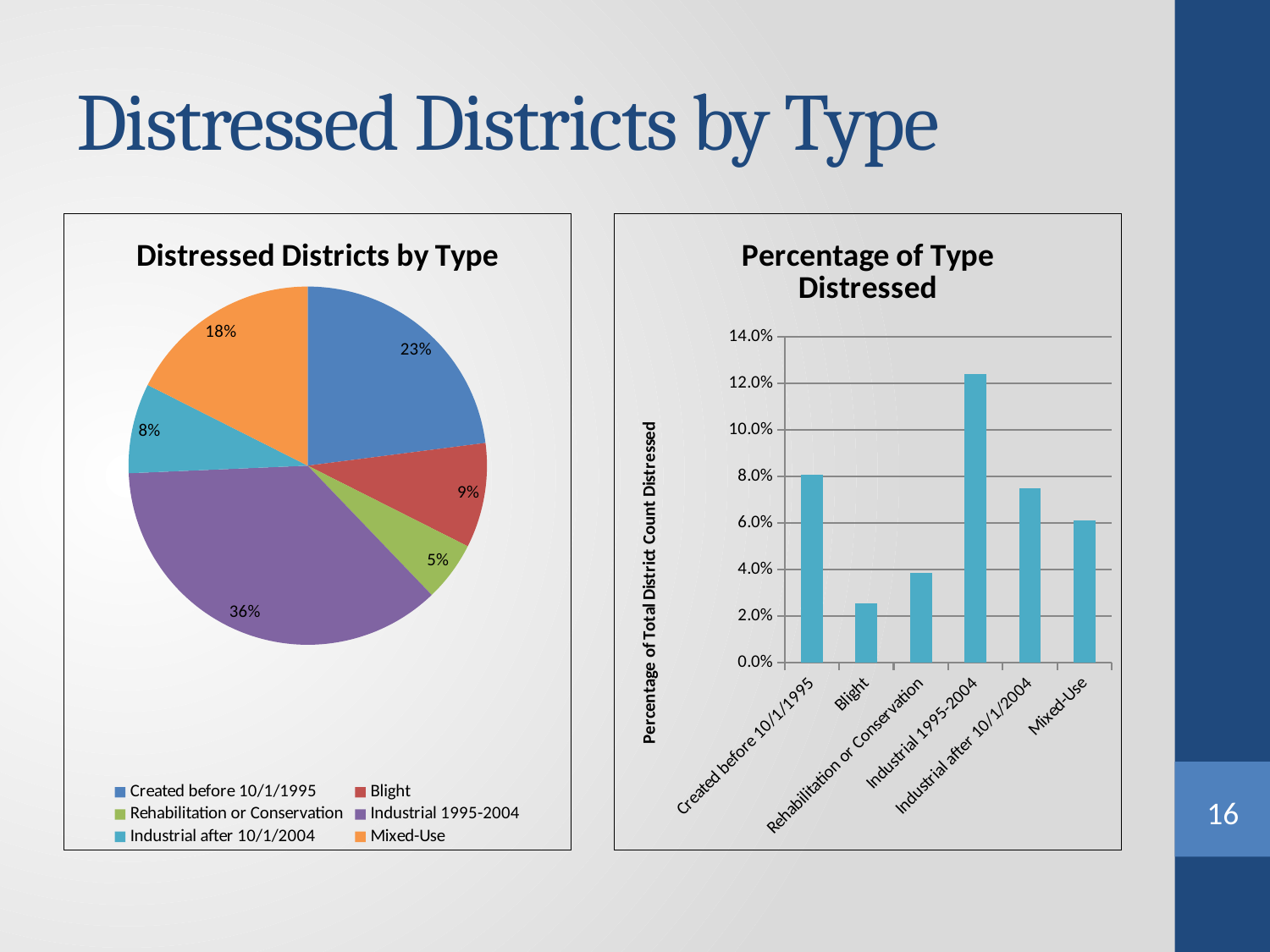
In the pie chart 'Distressed Districts by Type', which category has the smallest share? Rehabilitation or Conservation What type of chart is the chart on the right, 'Percentage of Type Distressed'? Bar chart In the pie chart 'Distressed Districts by Type', what share is Industrial 1995-2004? 36% In the pie chart 'Distressed Districts by Type', which category has the largest share? Industrial 1995-2004 In the bar chart 'Percentage of Type Distressed', which category has the highest bar? Industrial 1995-2004 In the pie chart 'Distressed Districts by Type', what is the difference in percentage points between Blight and Industrial after 10/1/2004? 1 percentage point In the pie chart 'Distressed Districts by Type', what share is Mixed-Use? 18% In the pie chart 'Distressed Districts by Type', how many categories does the legend list? 6 In the bar chart 'Percentage of Type Distressed', is the value for Industrial 1995-2004 greater or less than 12.0%? greater In the pie chart 'Distressed Districts by Type', what share is Created before 10/1/1995? 23% In the bar chart 'Percentage of Type Distressed', which category has the lowest bar? Blight